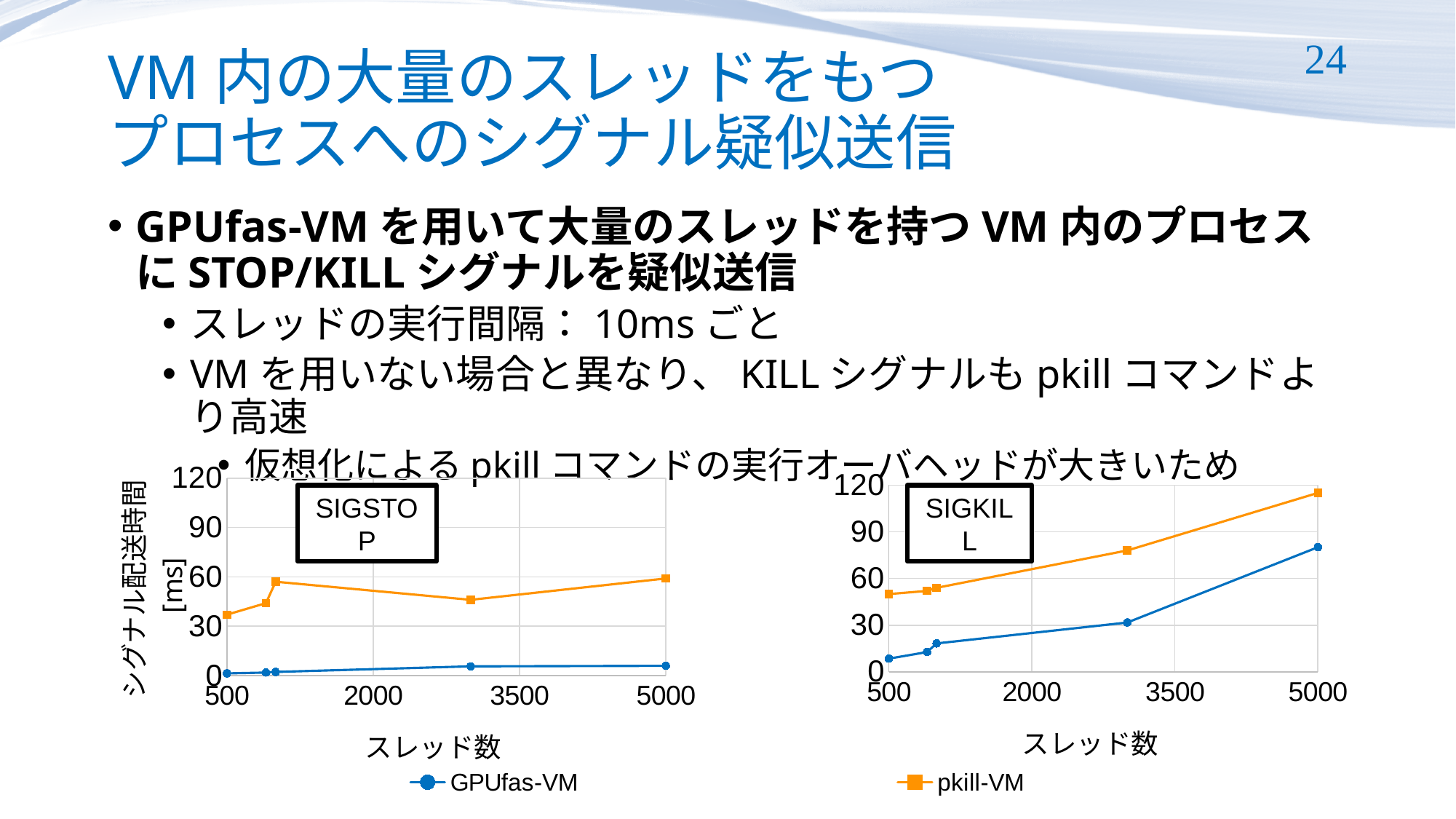
In the SIGKILL chart, at which thread count does pkill-VM reach its highest value? 5000 In the SIGSTOP chart, is the value for pkill-VM at 500 threads greater or less than 30? greater In the SIGKILL chart, is the value for pkill-VM at 5000 threads greater or less than 90? greater In the SIGKILL chart, is the value for GPUfas-VM at 500 threads greater or less than 30? less In the SIGKILL chart, which series has the larger value at 5000 threads, GPUfas-VM or pkill-VM? pkill-VM What kind of chart is the SIGSTOP chart on the left? line chart In the SIGKILL chart, does the GPUfas-VM line rise or fall as the number of threads increases? rise How many series does the legend list for the charts? 2 What is the label of the y axis shared by the two charts? シグナル配送時間 [ms]